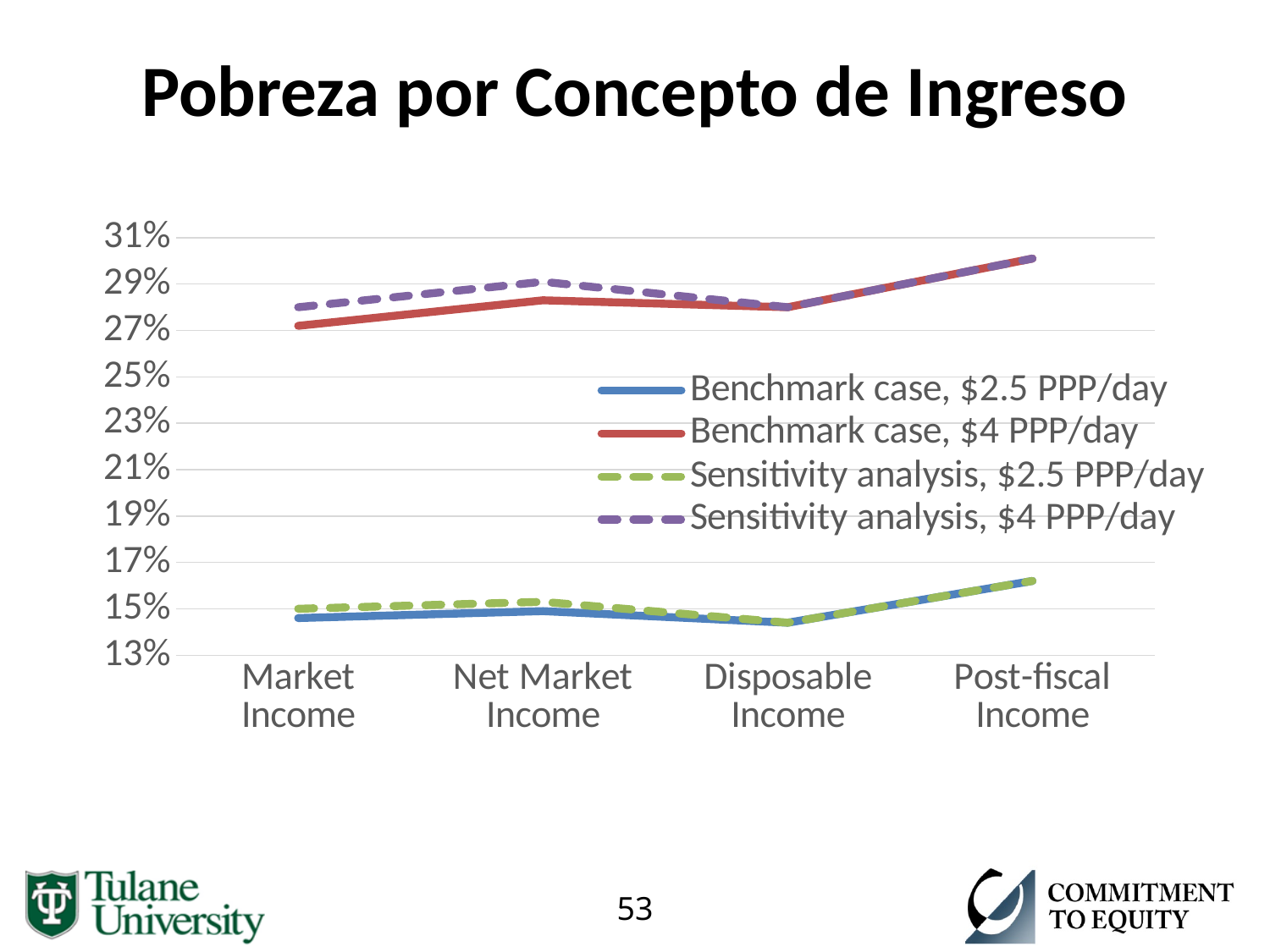
How many series does the legend list? 4 Is the value for 'Sensitivity analysis, $4 PPP/day' at Market Income greater or less than 29%? less Does the 'Benchmark case, $4 PPP/day' series rise or fall from Disposable Income to Post-fiscal Income? Rise Is the value for 'Benchmark case, $4 PPP/day' at Post-fiscal Income greater or less than 29%? greater For the 'Benchmark case, $4 PPP/day' series, which income concept has the highest value? Post-fiscal Income Is the value for 'Benchmark case, $2.5 PPP/day' at Market Income greater or less than 15%? less At Market Income, which is larger: 'Sensitivity analysis, $4 PPP/day' or 'Benchmark case, $4 PPP/day'? Sensitivity analysis, $4 PPP/day For the 'Benchmark case, $4 PPP/day' series, which income concept has the lowest value? Market Income How many income concepts are shown on the x axis? 4 What kind of chart is shown on the slide? Line chart For the 'Sensitivity analysis, $2.5 PPP/day' series, which income concept has the lowest value? Disposable Income What is the title of the chart? Pobreza por Concepto de Ingreso